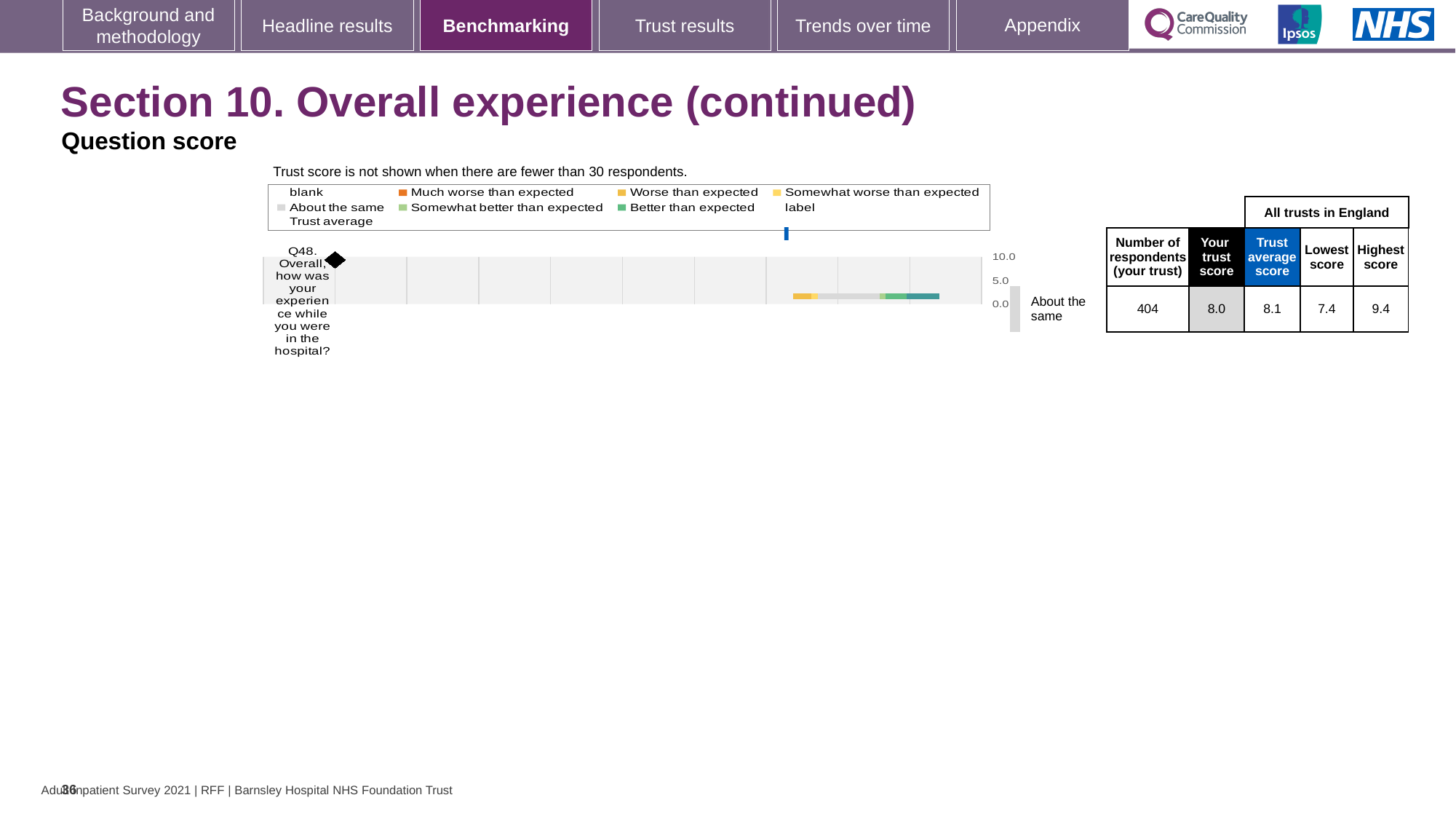
What is the trust average score for Q48? 8.1 Which is larger for Q48, your trust score or the trust average score? Trust average score What is the number of respondents for your trust for Q48? 404 What is the highest score among all trusts in England for Q48? 9.4 What kind of chart is used to show the Q48 benchmarking result? bar chart What is the difference between the highest score and the lowest score for Q48? 2.0 Which question is plotted on the chart? Q48. Overall, how was your experience while you were in the hospital? How many questions are plotted on the chart? 1 What benchmark category is shown next to the Q48 bar? About the same Is your trust score for Q48 greater or less than 5.0? greater What is the lowest score among all trusts in England for Q48? 7.4 What is your trust score for Q48? 8.0